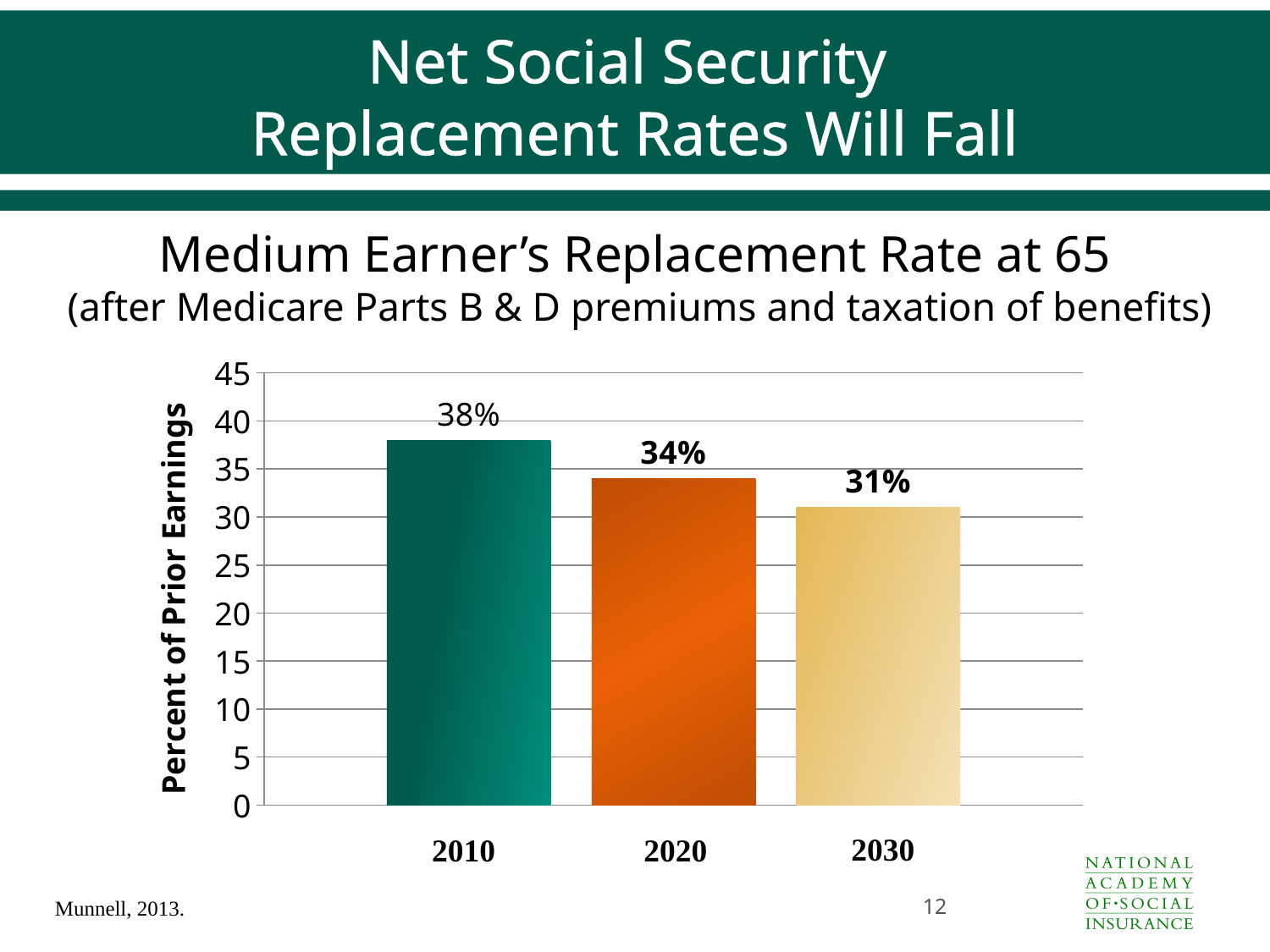
What is the replacement rate for 2010? 38% What is the difference between the replacement rates for 2020 and 2030? 3% Which year has the lowest replacement rate? 2030 Do the replacement rates rise or fall from 2010 to 2030? fall How many years are shown on the chart? 3 Which year has the highest replacement rate? 2010 Which is larger, the replacement rate for 2010 or for 2020? 2010 What is the replacement rate for 2030? 31% What is the replacement rate for 2020? 34% Is the value for 2030 greater or less than 35? less What is the difference between the replacement rates for 2010 and 2030? 7% What kind of chart is shown on the slide? bar chart